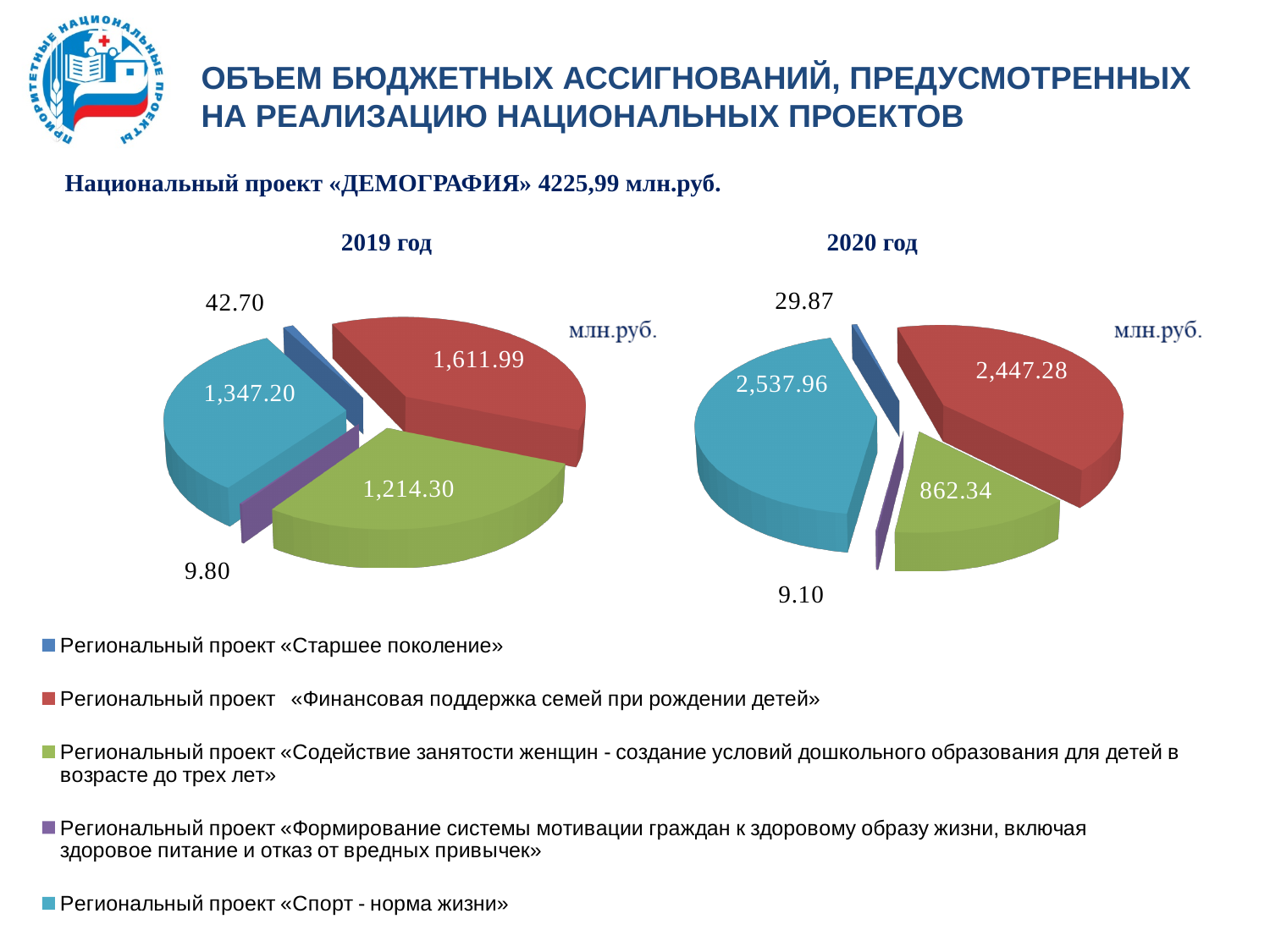
In the 2019 год pie chart, which regional project has the largest value? Региональный проект «Финансовая поддержка семей при рождении детей» What is the difference between the value for Региональный проект «Финансовая поддержка семей при рождении детей» in the 2020 год chart and in the 2019 год chart? 835.29 In the 2020 год pie chart, which is larger: the value for «Спорт - норма жизни» or the value for «Финансовая поддержка семей при рождении детей»? «Спорт - норма жизни» In the 2019 год pie chart, what is the difference between the values for «Финансовая поддержка семей при рождении детей» and «Спорт - норма жизни»? 264.79 What type of chart is used to show the 2020 год data? Pie chart How many slices does the 2019 год pie chart have? 5 What unit is shown next to the pie charts? млн.руб. In the 2020 год pie chart, what is the value for Региональный проект «Спорт - норма жизни»? 2,537.96 In the 2019 год pie chart, what is the value for Региональный проект «Финансовая поддержка семей при рождении детей»? 1,611.99 In the 2019 год pie chart, what is the value for Региональный проект «Старшее поколение»? 42.70 In the 2020 год pie chart, what is the value for Региональный проект «Содействие занятости женщин - создание условий дошкольного образования для детей в возрасте до трех лет»? 862.34 In the 2020 год pie chart, which regional project has the smallest value? Региональный проект «Формирование системы мотивации граждан к здоровому образу жизни, включая здоровое питание и отказ от вредных привычек»